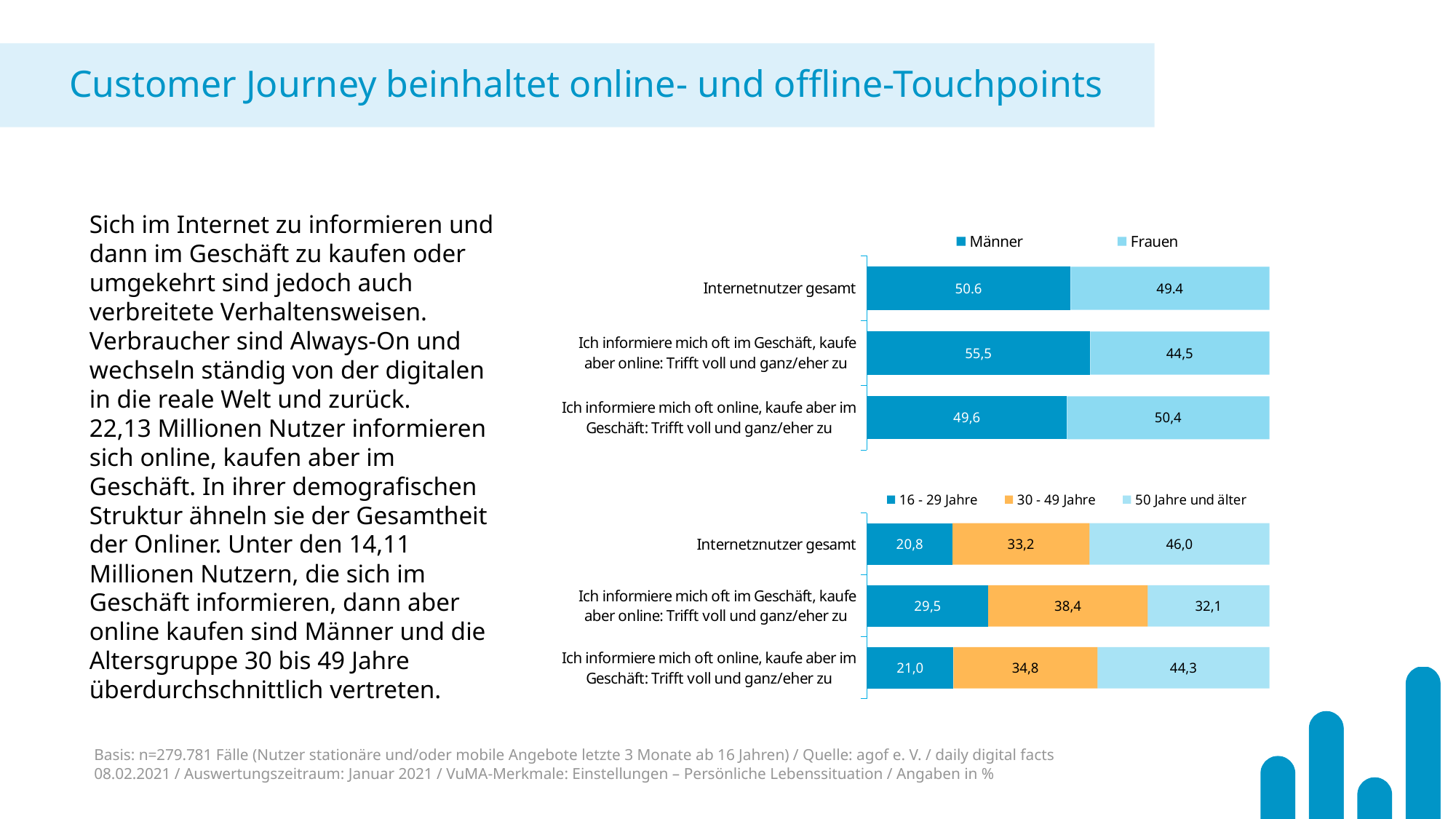
In the bottom chart (age groups), what is the value for '30 - 49 Jahre' in the 'Ich informiere mich oft im Geschäft, kaufe aber online' bar? 38,4 In the bottom chart (age groups), what is the value for '50 Jahre und älter' in the 'Internetznutzer gesamt' bar? 46,0 In the top chart (Männer/Frauen), what is the difference between Männer and Frauen in the 'Ich informiere mich oft im Geschäft, kaufe aber online' bar? 11,0 In the bottom chart (age groups), which age group has the smallest share in the 'Internetznutzer gesamt' bar? 16 - 29 Jahre In the bottom chart (age groups), how many series does the legend list? 3 What type of chart is the bottom chart (age groups)? Stacked bar chart In the bottom chart (age groups), what is the value for '16 - 29 Jahre' in the 'Ich informiere mich oft online, kaufe aber im Geschäft' bar? 21,0 In the top chart (Männer/Frauen), what is the value for Männer in the 'Internetnutzer gesamt' bar? 50.6 In the top chart (Männer/Frauen), what is the value for Männer in the 'Ich informiere mich oft online, kaufe aber im Geschäft' bar? 49,6 In the top chart (Männer/Frauen), how many series does the legend list? 2 In the top chart (Männer/Frauen), what is the value for Frauen in the 'Ich informiere mich oft im Geschäft, kaufe aber online' bar? 44,5 In the bottom chart (age groups), which age group has the largest share in the 'Ich informiere mich oft im Geschäft, kaufe aber online' bar? 30 - 49 Jahre